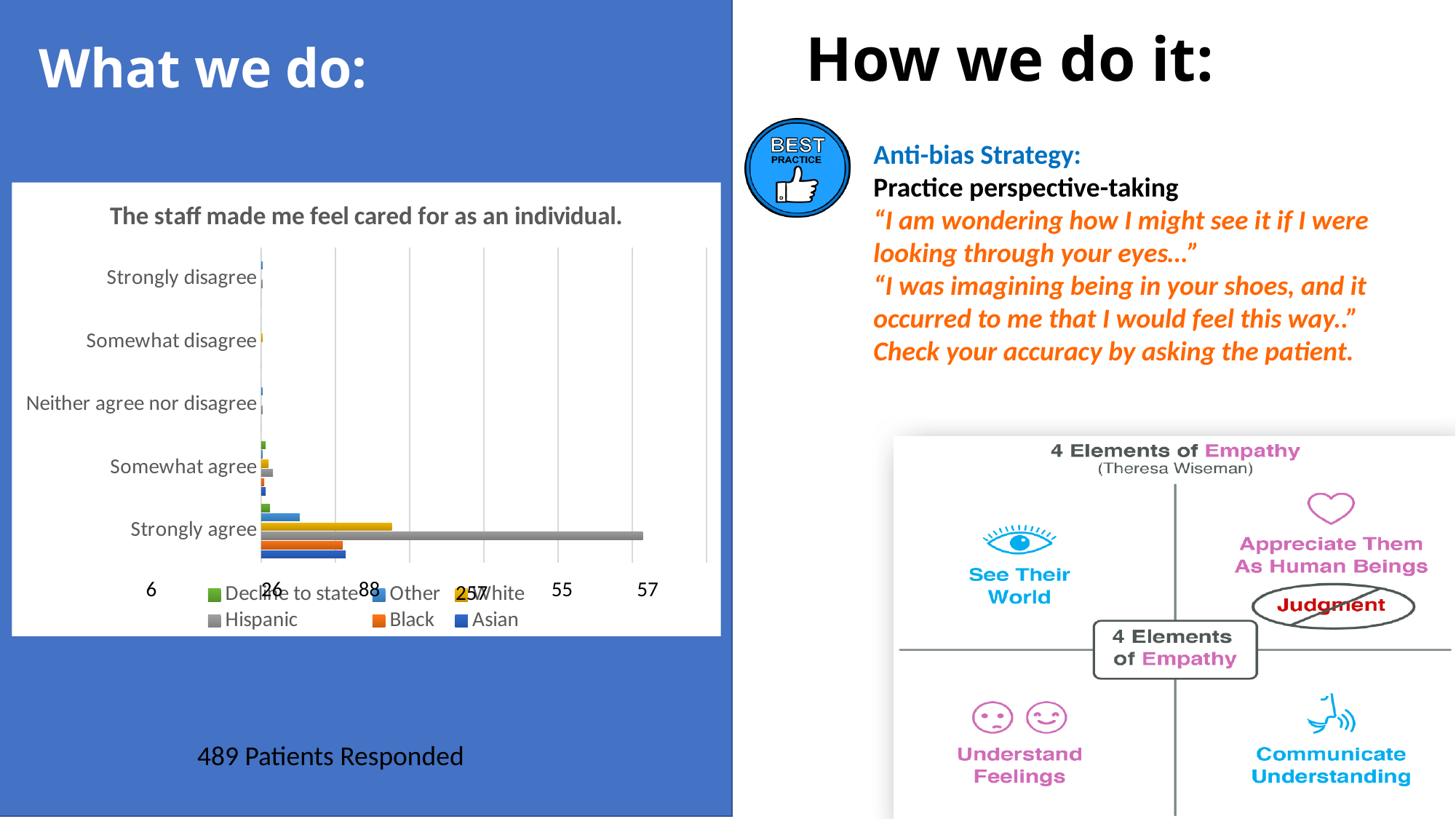
What is the title of the chart? The staff made me feel cared for as an individual. In the Strongly agree category, which bar is longer: Hispanic or White? Hispanic What kind of chart is shown on the slide? Bar chart Which response category has the second-longest bars after Strongly agree? Somewhat agree How many series does the chart's legend list? 6 Which series has the longest bar in the Strongly agree category? Hispanic In the Strongly agree category, which bar is longer: White or Other? White How many response categories are shown on the chart's vertical axis? 5 Which legend entry is shown in gray? Hispanic Which response category has the longest bars overall? Strongly agree How many patients responded to the survey, according to the slide? 489